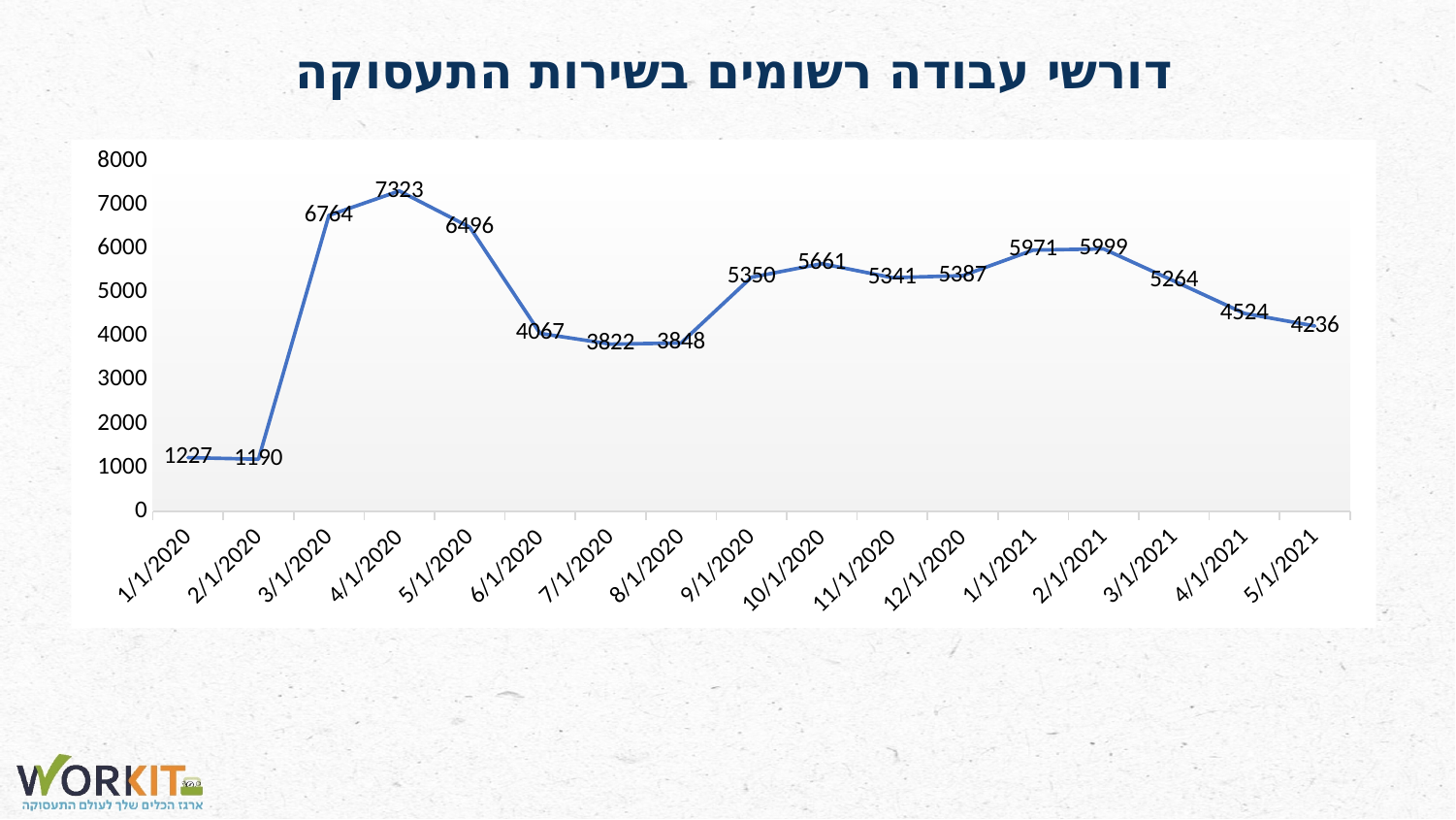
What is the value for 5/1/2021? 4236 Which is larger, the value for 10/1/2020 or the value for 9/1/2020? 10/1/2020 Do the values rise or fall from 2/1/2021 to 5/1/2021? fall What kind of chart is shown on the slide? line chart How many data points are plotted on the chart? 17 Is the value for 6/1/2020 greater or less than 5000? less What is the value for 4/1/2020? 7323 What is the value for 7/1/2020? 3822 Which date has the lowest value? 2/1/2020 What is the difference between the values for 3/1/2020 and 2/1/2020? 5574 What is the difference between the values for 2/1/2021 and 5/1/2021? 1763 Which date has the highest value? 4/1/2020